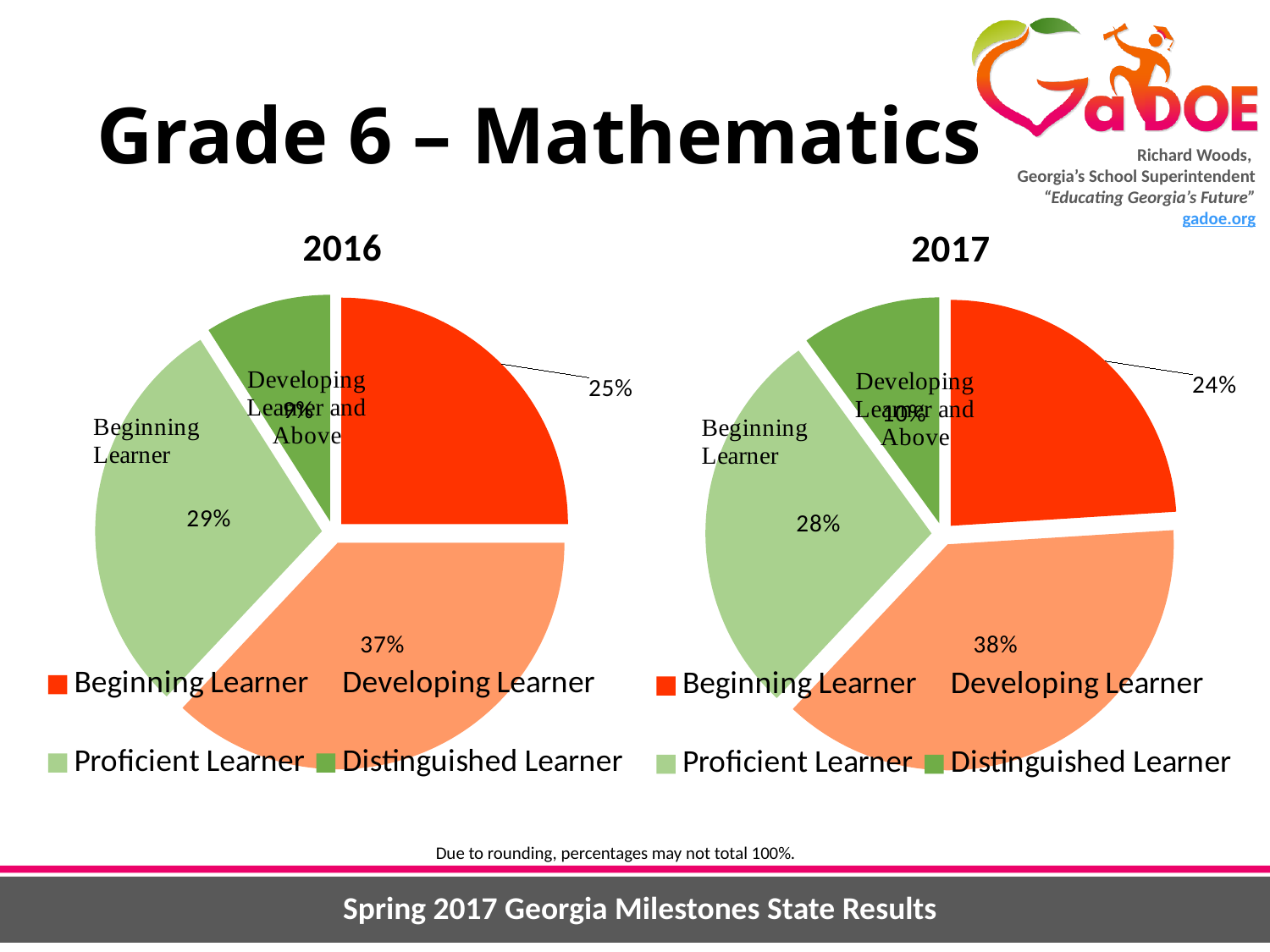
How many entries does the legend of the 2016 chart list? 4 In the 2017 pie chart, what is the difference between the Developing Learner and Beginning Learner percentages? 14% In the 2017 pie chart, which category has the smallest share? Distinguished Learner What colour represents Beginning Learner in the legend of the 2017 chart? Red In the 2017 pie chart, what percentage is shown for Beginning Learner? 24% What type of chart is used to show the 2016 results? Pie chart In the 2016 pie chart, which category has the largest share? Developing Learner How many slices does the 2017 pie chart have? 4 In the 2016 pie chart, what percentage is shown for Proficient Learner? 29% In the 2016 pie chart, which is larger: Beginning Learner or Proficient Learner? Proficient Learner In the 2016 pie chart, what percentage is shown for Developing Learner? 37% In the 2017 pie chart, what percentage is shown for Proficient Learner? 28%